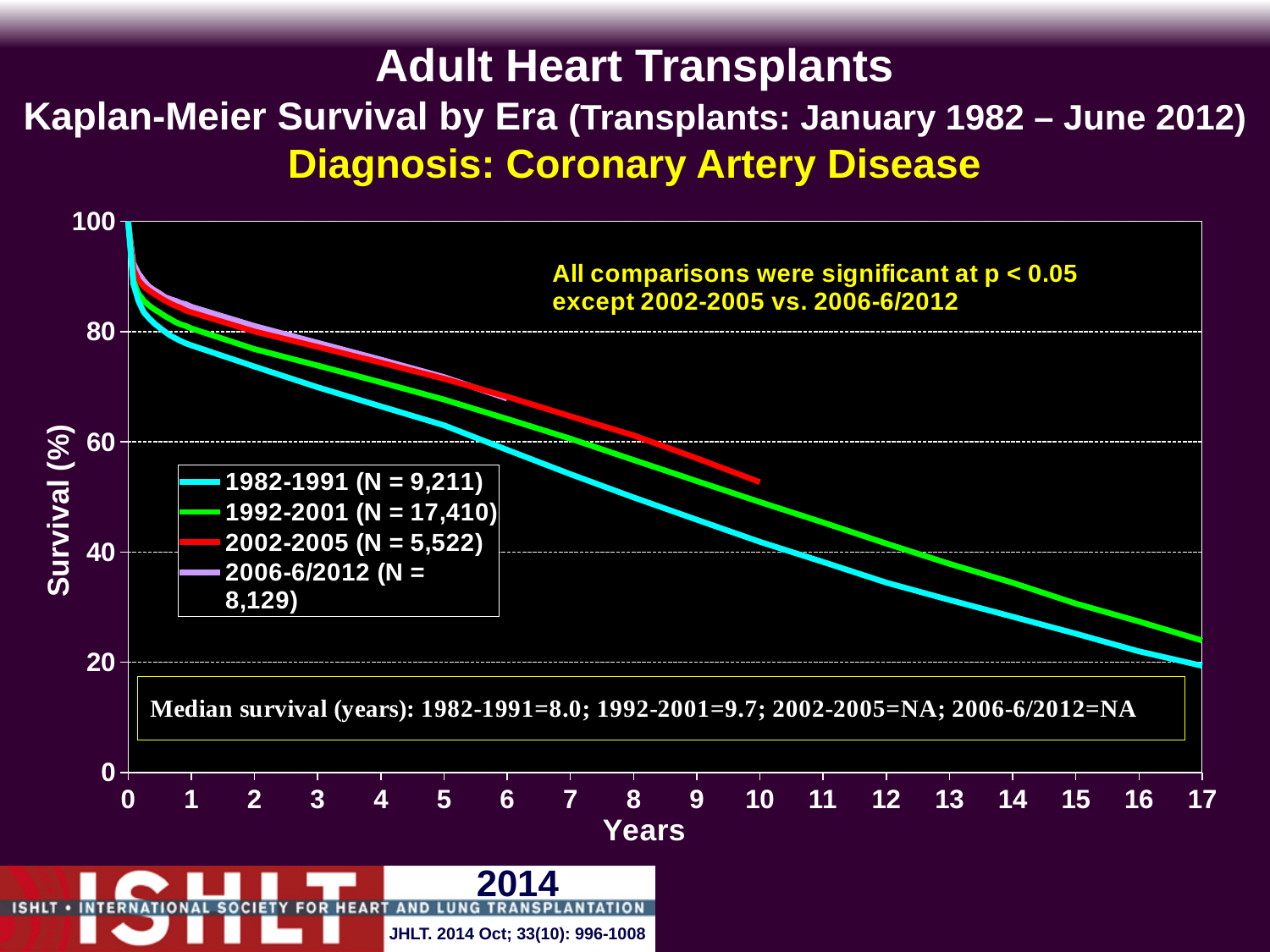
Which era has the lowest survival curve across the chart? 1982-1991 Is the survival value for the 2002-2005 era at 10 years greater or less than 60? less Do the survival curves rise or fall as years increase? fall At 5 years, which curve is higher: 1982-1991 or 1992-2001? 1992-2001 What is the difference in median survival (years) between the 1992-2001 and 1982-1991 eras? 1.7 What is the N for the 1992-2001 era shown in the legend? 17,410 How many series does the legend list? 4 What is the median survival in years for the 1982-1991 era? 8.0 Is the survival value for the 1992-2001 era at 17 years greater or less than 40? less What is the label of the y axis? Survival (%) What is the median survival in years for the 1992-2001 era? 9.7 What kind of chart is shown on the slide? line chart